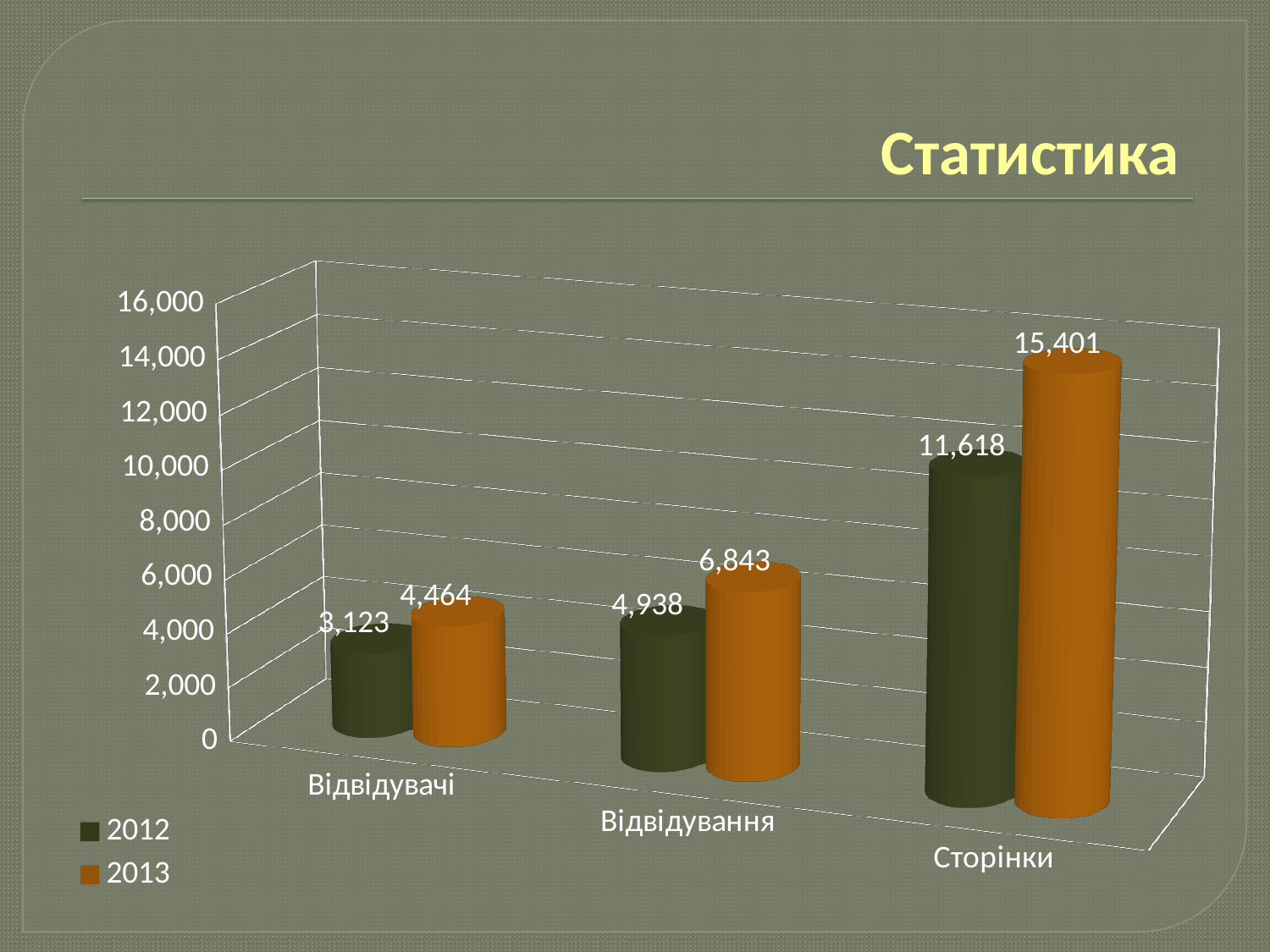
What is the difference between the 2013 and 2012 values for Відвідувачі? 1,341 How many categories are shown on the x axis? 3 Which category has the lowest value in the 2012 series? Відвідувачі How many series does the legend list? 2 What is the value for Відвідувачі in the 2012 series? 3,123 What is the value for Сторінки in the 2013 series? 15,401 What is the value for Сторінки in the 2012 series? 11,618 Which is larger: the 2012 value for Відвідування or the 2013 value for Відвідувачі? 2012 value for Відвідування What is the value for Відвідування in the 2013 series? 6,843 What kind of chart is shown on the slide? Bar chart Which category has the highest value in the 2013 series? Сторінки What is the difference between the 2013 and 2012 values for Сторінки? 3,783